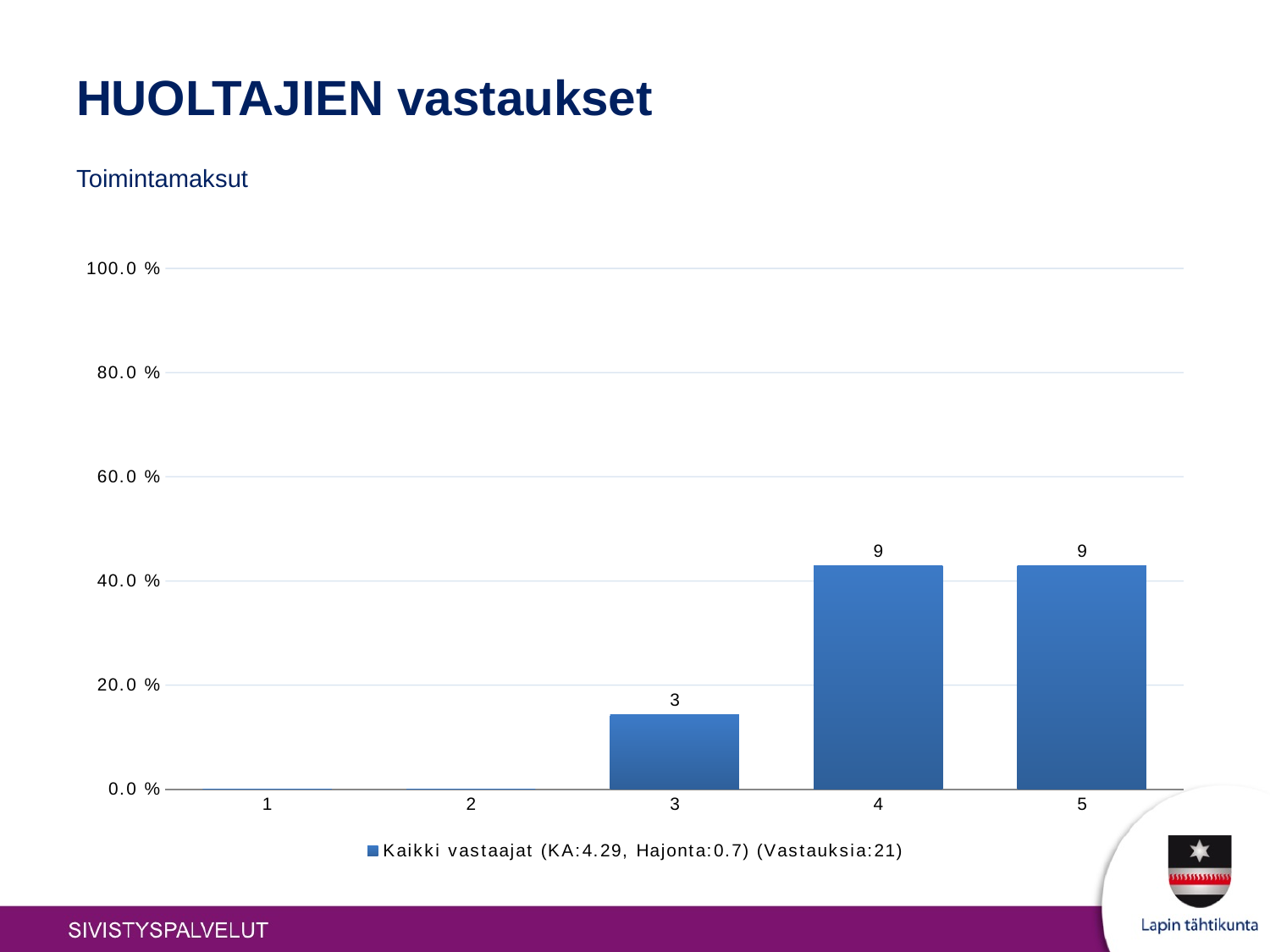
Do the values rise or fall from category 1 to category 5? rise What is the difference between the data labels for category 4 and category 3? 6 Which has the larger value, category 3 or category 4? 4 How many series does the legend list? 1 What is the data label on the bar for category 3? 3 How many categories are shown on the x axis? 5 Is the value for category 3 greater or less than 20.0 %? less What is the subtitle of the chart shown below the slide title? Toimintamaksut What kind of chart is shown on the slide? bar chart Is the value for category 4 greater or less than 40.0 %? greater What is the data label on the bar for category 4? 9 What is the data label on the bar for category 5? 9